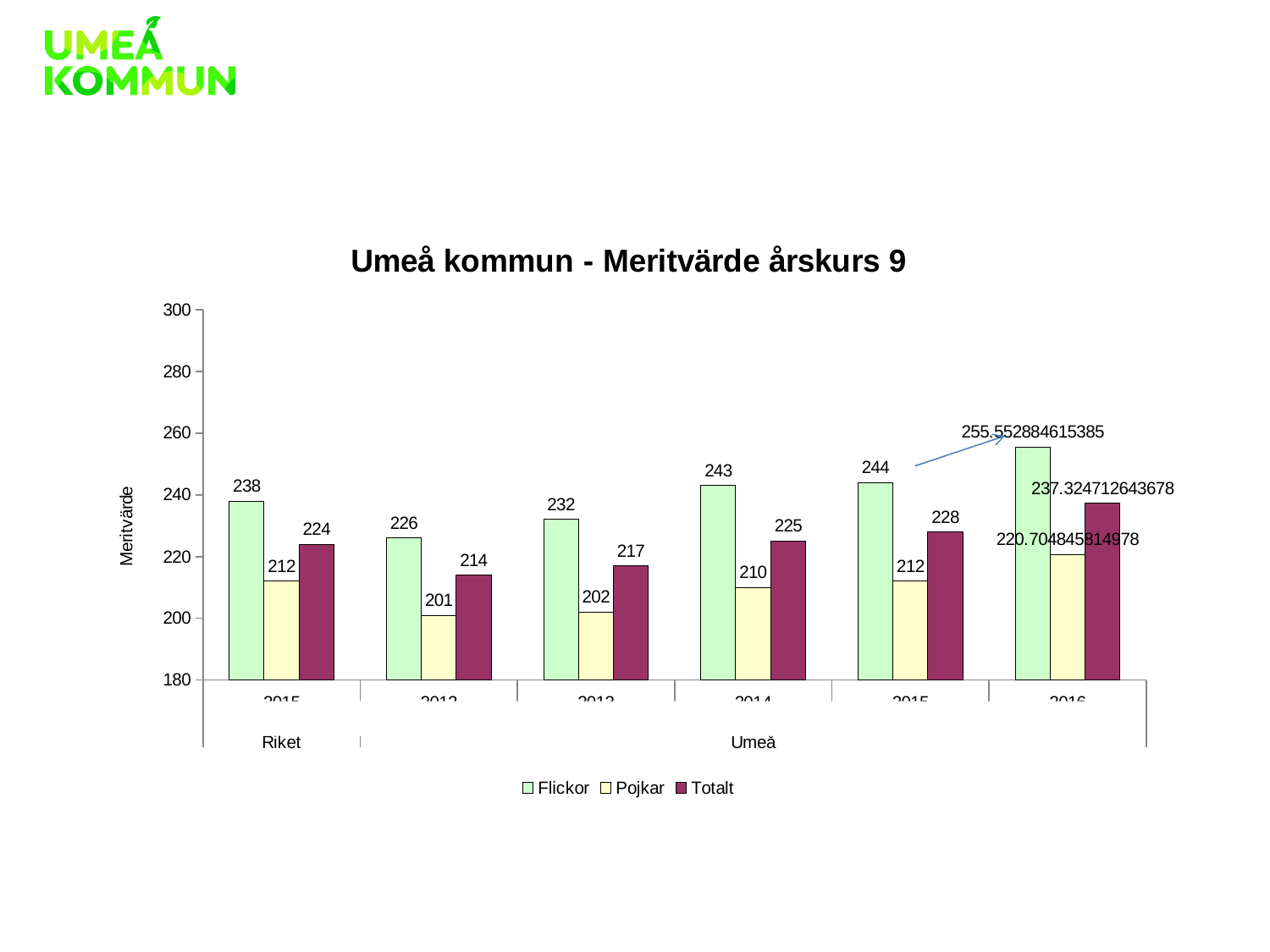
What is the Totalt value for Umeå in 2015? 228 Is the Flickor value for Umeå in 2016 greater or less than 240? greater Which category group has the lowest Pojkar value? Umeå 2012 Which category group has the highest Flickor value? Umeå 2016 Do the Flickor values for Umeå rise or fall from 2012 to 2016? rise How many series does the legend list? 3 What is the Totalt value for Umeå in 2012? 214 What is the Pojkar value for Umeå in 2014? 210 What is the difference between the Flickor and Pojkar values for Riket? 26 Which is larger, the Totalt value for Riket or the Totalt value for Umeå in 2013? Riket What is the Flickor value for Riket? 238 What kind of chart is shown on the slide? bar chart